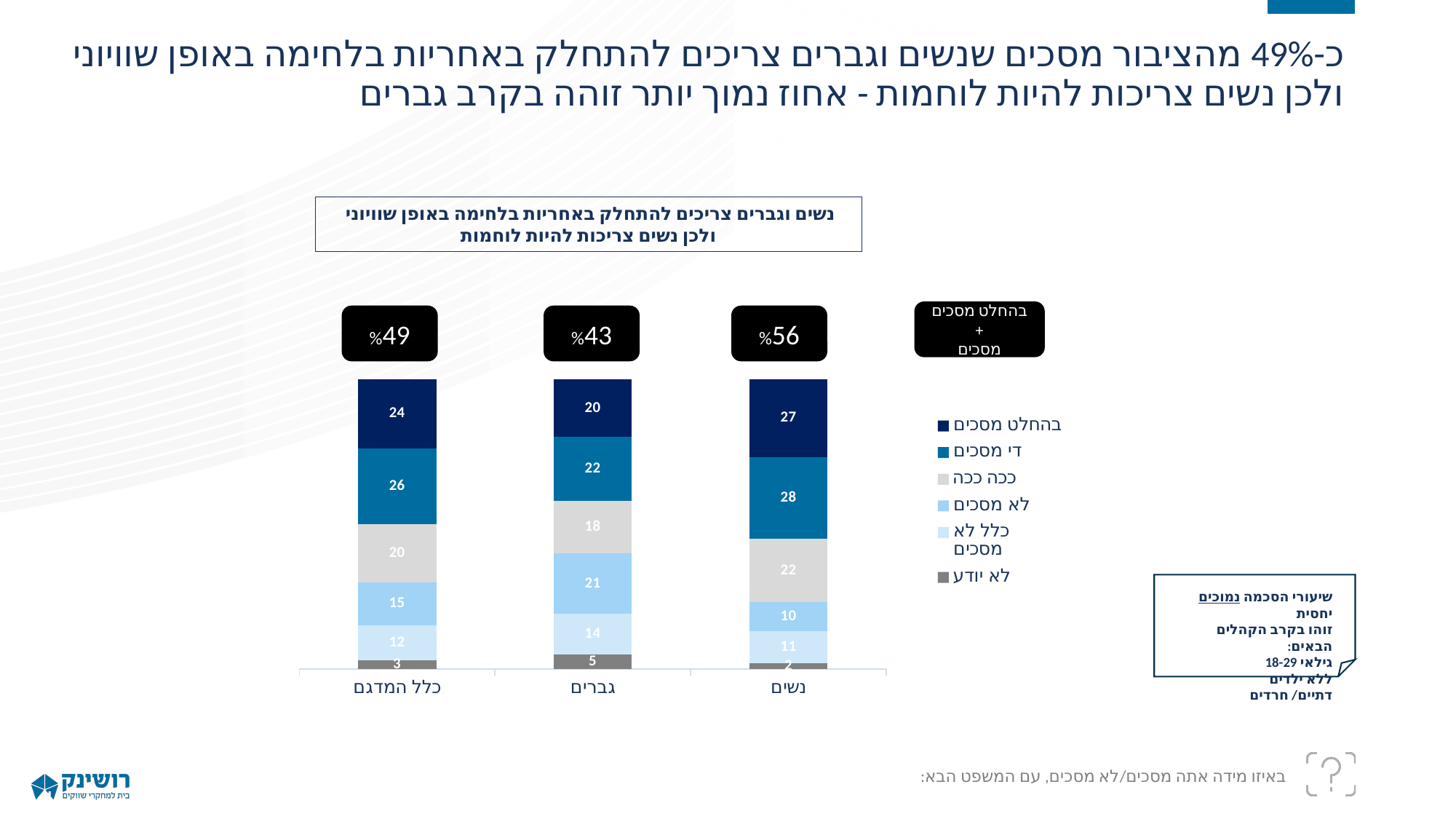
How many series does the chart legend list? 6 Which category has the lowest value for לא יודע? נשים Which category has the highest combined בהחלט מסכים + מסכים percentage shown above its bar? נשים What is the total of the stacked bar for כלל המדגם? 100 What is the difference between the די מסכים values for נשים and גברים? 6 What is the value of לא מסכים for גברים? 21 How many categories are shown on the x axis of the chart? 3 What kind of chart is shown on the slide? Stacked bar chart What is the value of בהחלט מסכים for נשים? 27 Which is larger: the לא מסכים value for גברים or for נשים? גברים What is the value of ככה ככה for כלל המדגם? 20 What is the combined בהחלט מסכים + מסכים percentage shown above the bar for גברים? 43%